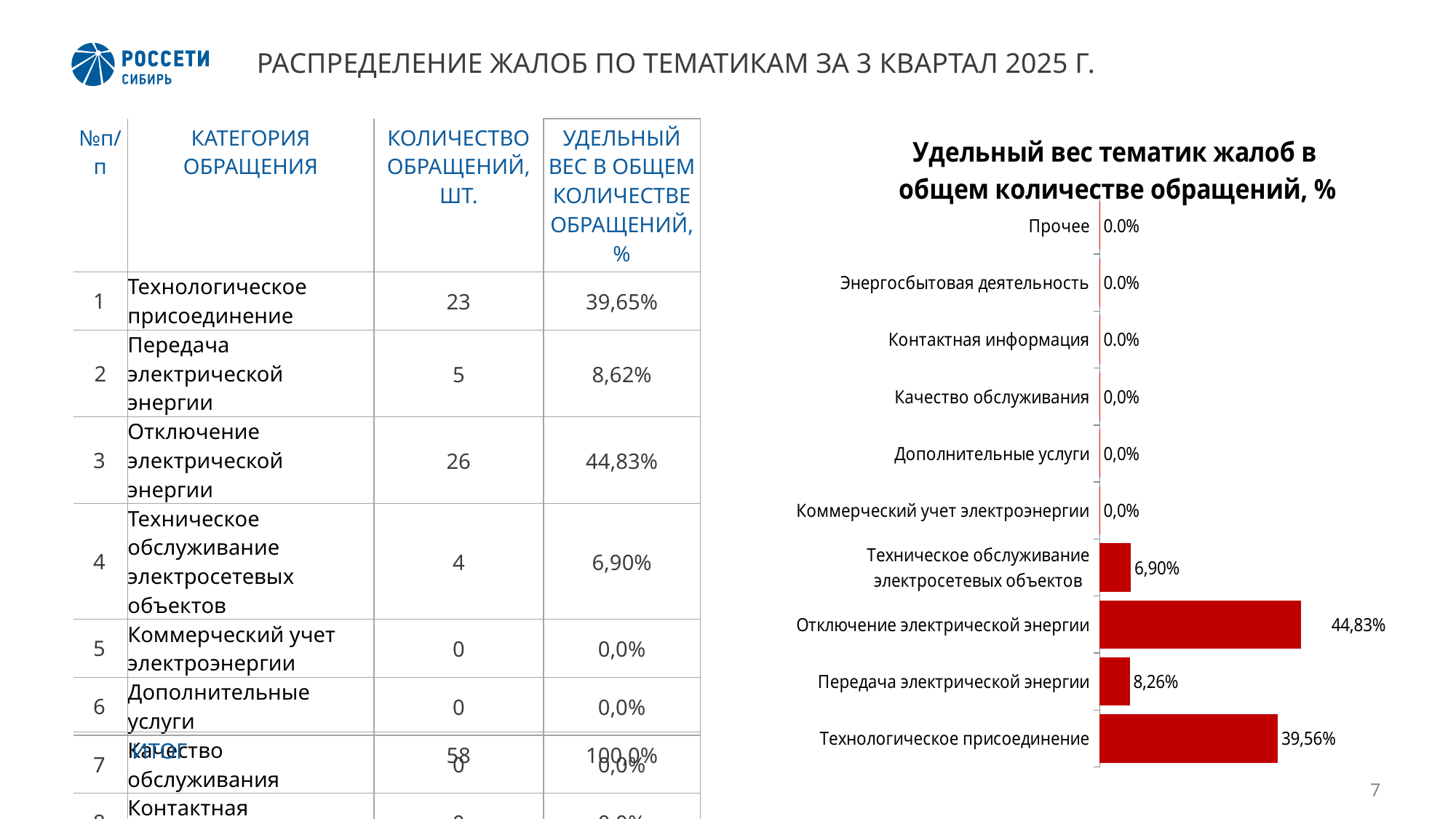
In the chart, what is the value for Передача электрической энергии? 8,26% What is the chart's title? Удельный вес тематик жалоб в общем количестве обращений, % How many categories in the chart have a value of 0,0%? 6 In the chart, what is the value for Технологическое присоединение? 39,56% How many categories are shown in the chart? 10 In the chart, what is the value for Техническое обслуживание электросетевых объектов? 6,90% What type of chart is shown on the slide? bar chart In the chart, what is the value for Отключение электрической энергии? 44,83% Which category has the highest value in the chart? Отключение электрической энергии In the chart, what is the value for Прочее? 0.0% In the chart, what is the difference between Отключение электрической энергии and Технологическое присоединение? 5,27%